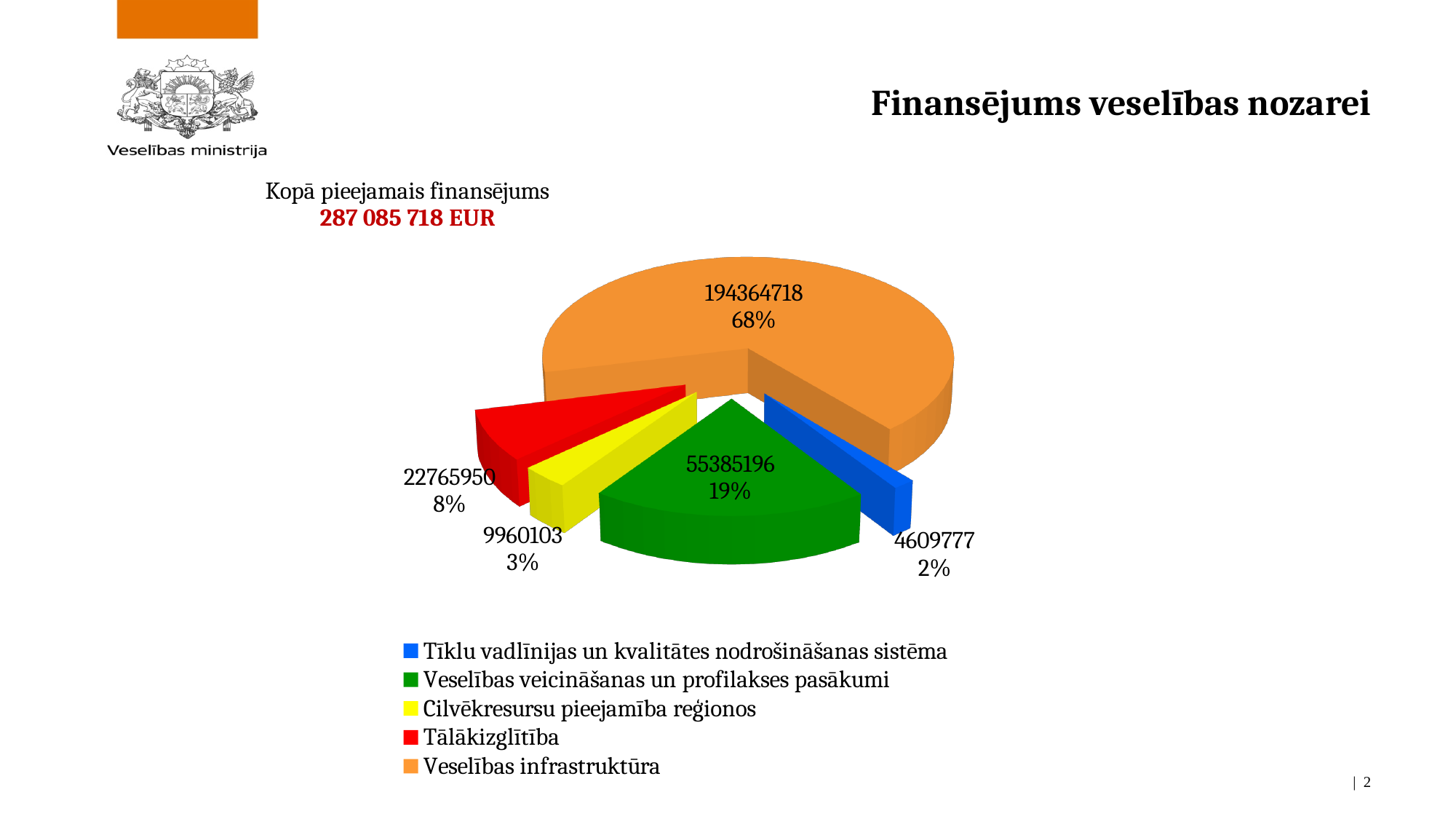
How many slices does the pie chart have? 5 Which category has the smallest slice? Tīklu vadlīnijas un kvalitātes nodrošināšanas sistēma What share of the pie does Tīklu vadlīnijas un kvalitātes nodrošināšanas sistēma represent? 2% What is the value for Veselības infrastruktūra? 194364718 How many entries does the legend list? 5 Which is larger, the value for Cilvēkresursu pieejamība reģionos or the value for Tīklu vadlīnijas un kvalitātes nodrošināšanas sistēma? Cilvēkresursu pieejamība reģionos What is the value for Veselības veicināšanas un profilakses pasākumi? 55385196 Which category has the largest slice? Veselības infrastruktūra What type of chart is shown on the slide? Pie chart What is the value for Cilvēkresursu pieejamība reģionos? 9960103 What is the value for Tālākizglītība? 22765950 What is the difference between the values for Veselības veicināšanas un profilakses pasākumi and Tālākizglītība? 32619246